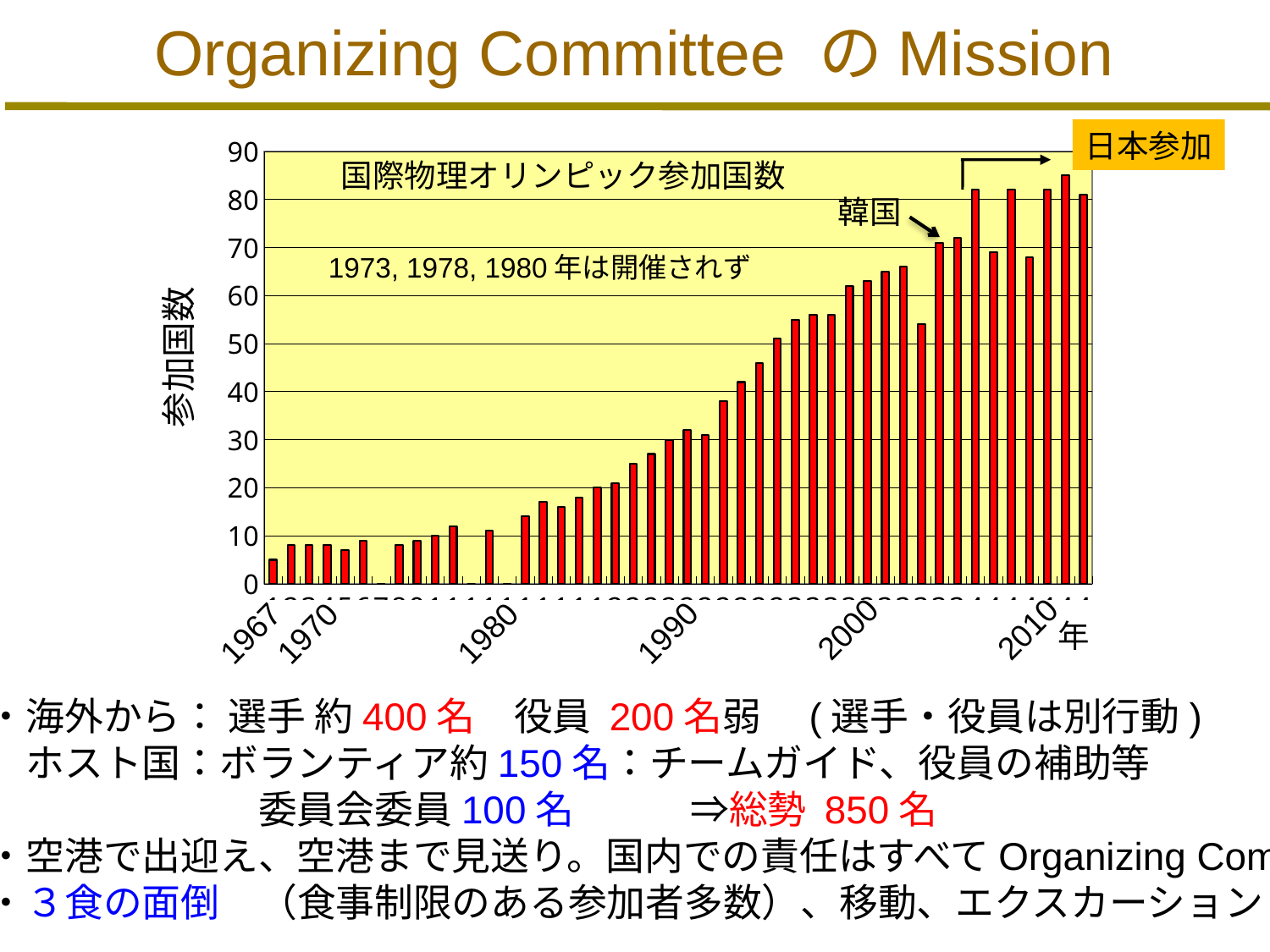
What is the title of the chart? 国際物理オリンピック参加国数 Is the value for 1967 greater or less than 10? less What kind of chart is shown on the slide? bar chart Which year has more participating countries, 2000 or 2010? 2010 Overall, do the values rise or fall from 1967 to 2010? rise Is the value for 2010 greater or less than 70? greater What is the label on the vertical axis of the chart? 参加国数 Is the value for 1970 greater or less than 10? less Which year has more participating countries, 1990 or 2000? 2000 Which year has the lowest number of participating countries, 1967 or 1970? 1967